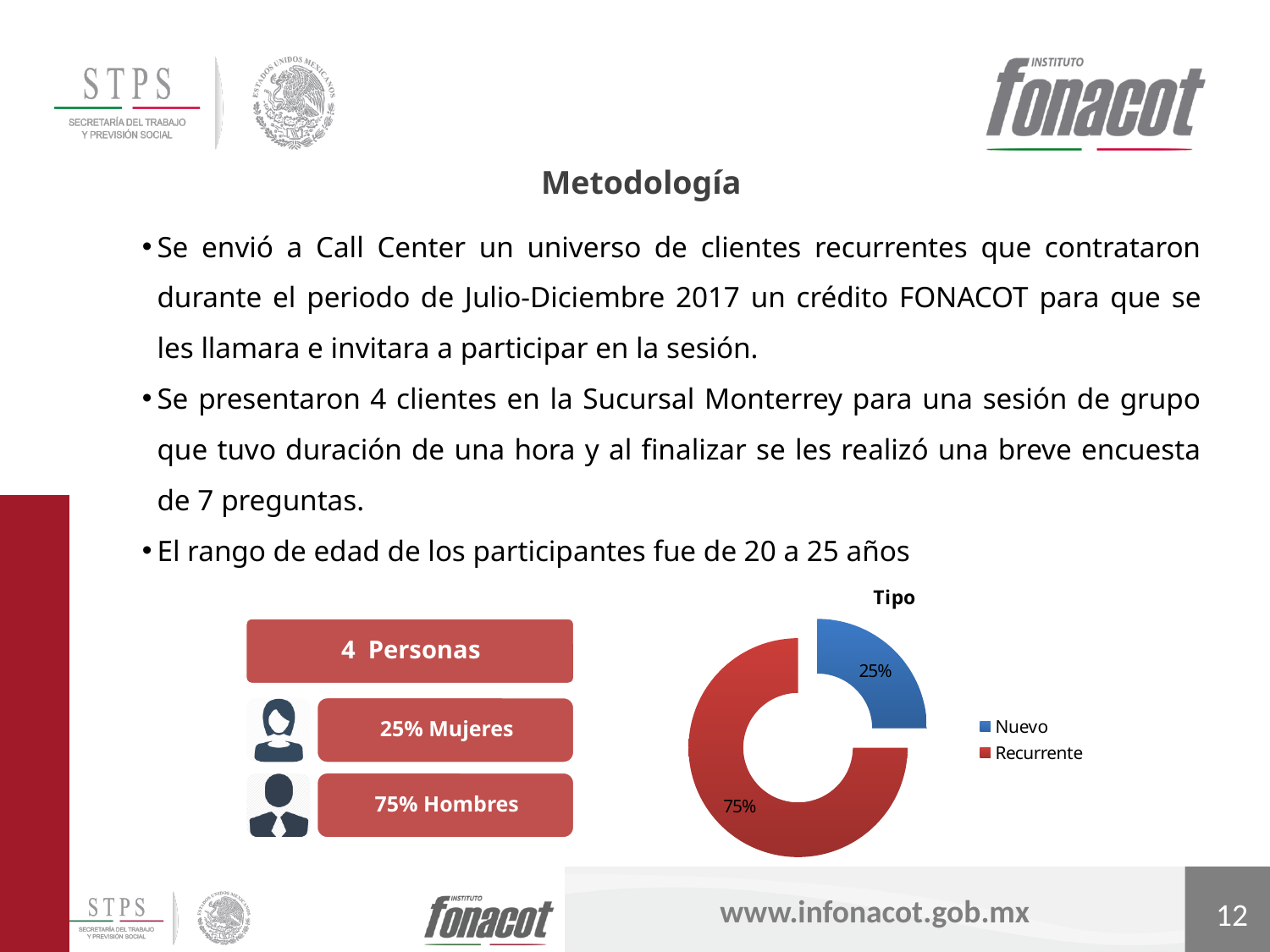
What colour represents 'Recurrente' in the 'Tipo' chart? Red What share of the 'Tipo' chart is 'Nuevo'? 25% What kind of chart is the 'Tipo' chart? Doughnut chart What is the title of the chart on the slide? Tipo What share of the 'Tipo' chart is 'Recurrente'? 75% What is the difference in percentage points between 'Recurrente' and 'Nuevo' in the 'Tipo' chart? 50 percentage points Which category has the smallest share in the 'Tipo' chart? Nuevo Which category has the largest share in the 'Tipo' chart? Recurrente How many categories does the legend of the 'Tipo' chart list? 2 In the 'Tipo' chart, which is larger, 'Nuevo' or 'Recurrente'? Recurrente